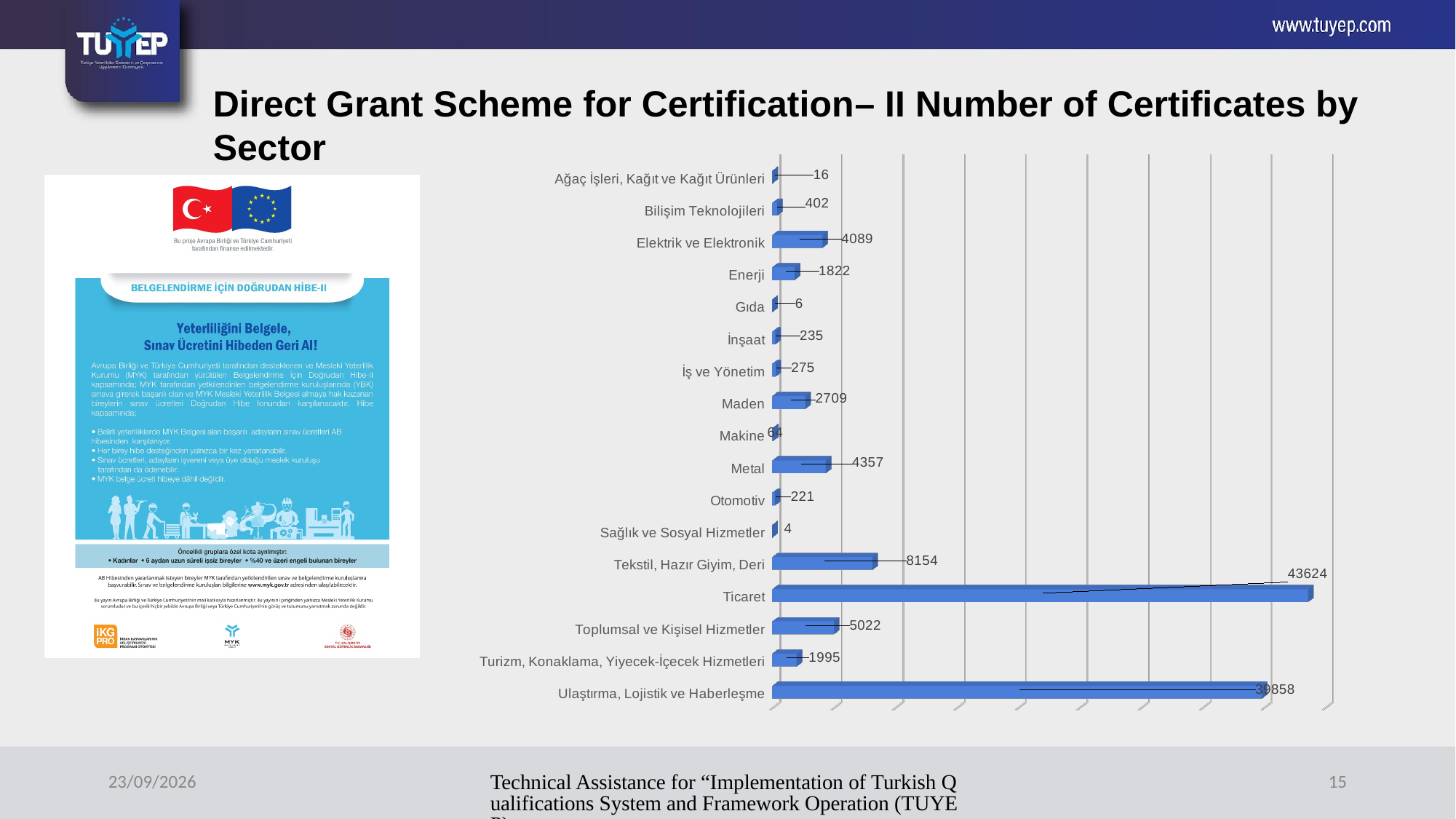
Which sector has the lowest number of certificates? Sağlık ve Sosyal Hizmetler Which is larger, the value for Toplumsal ve Kişisel Hizmetler or the value for Maden? Toplumsal ve Kişisel Hizmetler How many sectors are shown in the chart? 17 What is the value for Tekstil, Hazır Giyim, Deri? 8154 How many certificates are shown for Ticaret? 43624 What is the value for Enerji? 1822 Which sector has the highest number of certificates? Ticaret What is the difference between the values for Ticaret and Ulaştırma, Lojistik ve Haberleşme? 3766 What is the value for Ulaştırma, Lojistik ve Haberleşme? 39858 What type of chart is shown on the slide? Bar chart What is the title of the slide containing the chart? Direct Grant Scheme for Certification– II Number of Certificates by Sector What is the difference between the values for Metal and Elektrik ve Elektronik? 268